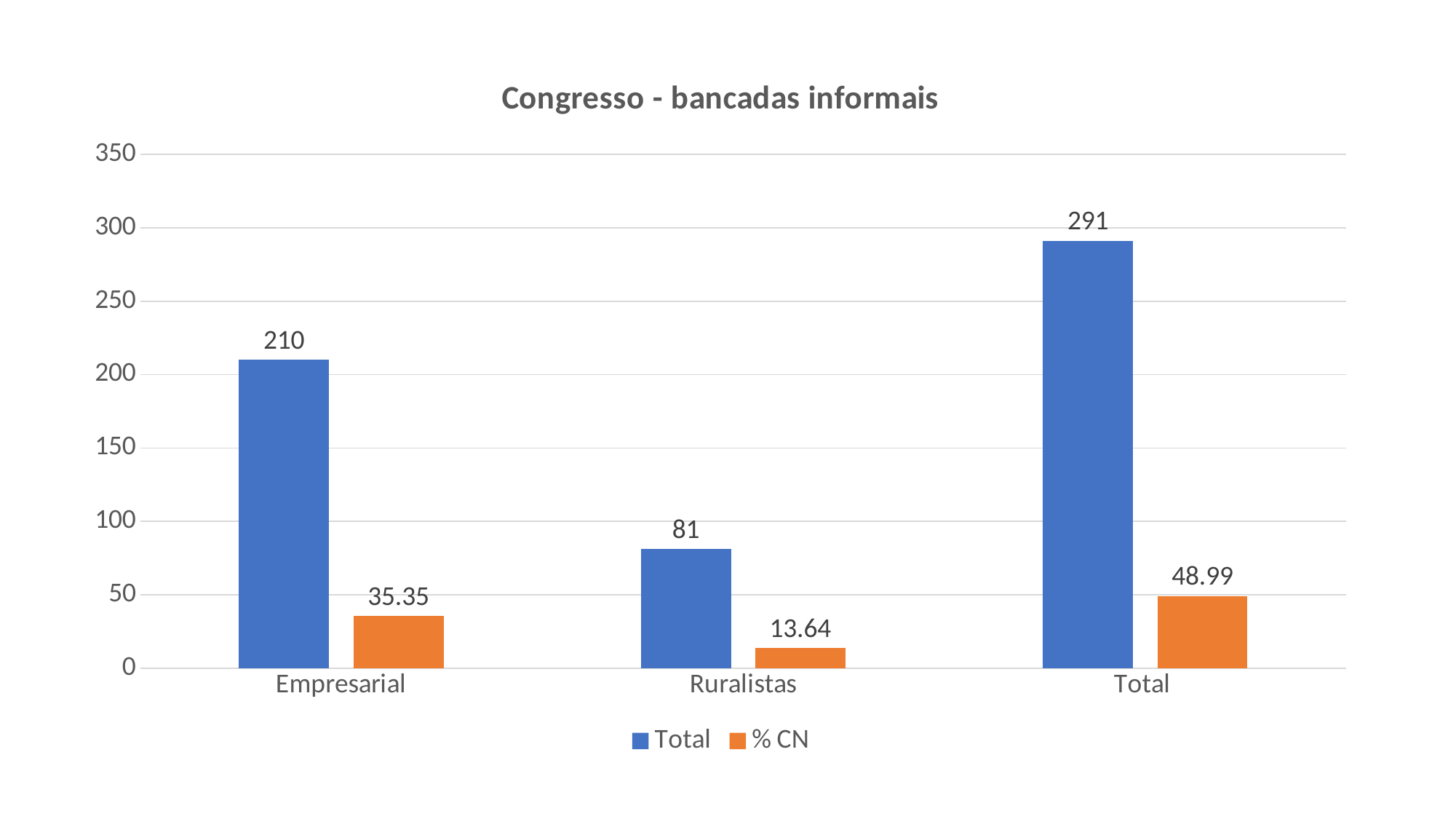
What is the Total value for Ruralistas? 81 Which is larger, the % CN value for Empresarial or for Ruralistas? Empresarial Is the Total value for Ruralistas greater or less than 100? less What type of chart is shown? bar chart Which category has the lowest % CN value? Ruralistas How many series does the legend list? 2 What is the difference between the Total values for Empresarial and Ruralistas? 129 What is the Total value for Empresarial? 210 Which category has the highest Total value? Total What is the % CN value for Ruralistas? 13.64 What is the % CN value for the Total category? 48.99 How many categories are shown on the x axis? 3